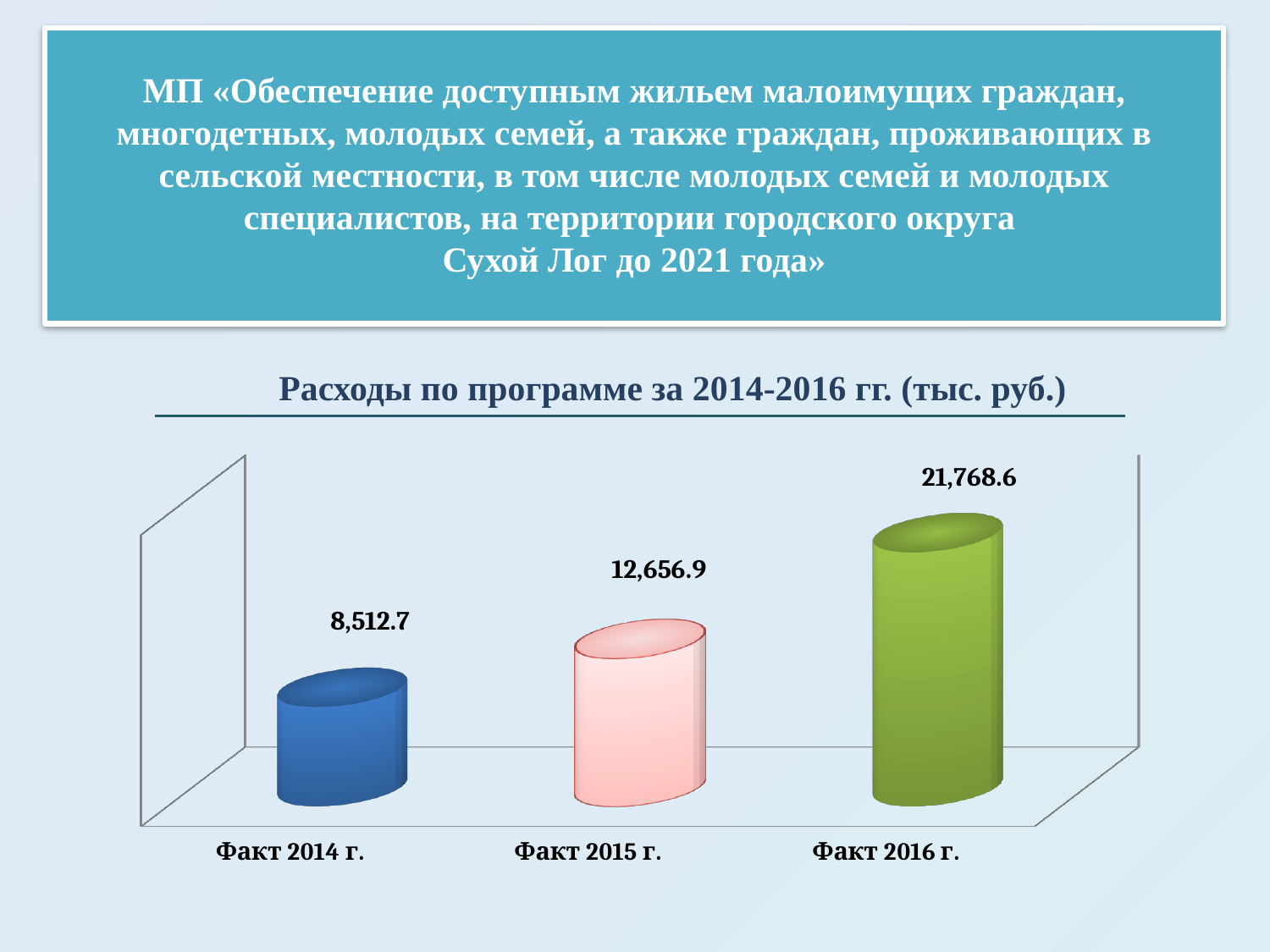
What is the difference between the values for Факт 2015 г. and Факт 2014 г.? 4,144.2 What is the value for Факт 2015 г.? 12,656.9 Do the values rise or fall from Факт 2014 г. to Факт 2016 г.? Rise Which category has the lowest value? Факт 2014 г. Which is larger, the value for Факт 2015 г. or the value for Факт 2016 г.? Факт 2016 г. Which category has the highest value? Факт 2016 г. What kind of chart is shown on the slide? Bar chart What is the title of the chart? Расходы по программе за 2014-2016 гг. (тыс. руб.) What is the difference between the values for Факт 2016 г. and Факт 2015 г.? 9,111.7 What is the value for Факт 2016 г.? 21,768.6 What is the value for Факт 2014 г.? 8,512.7 How many categories are shown on the chart? 3